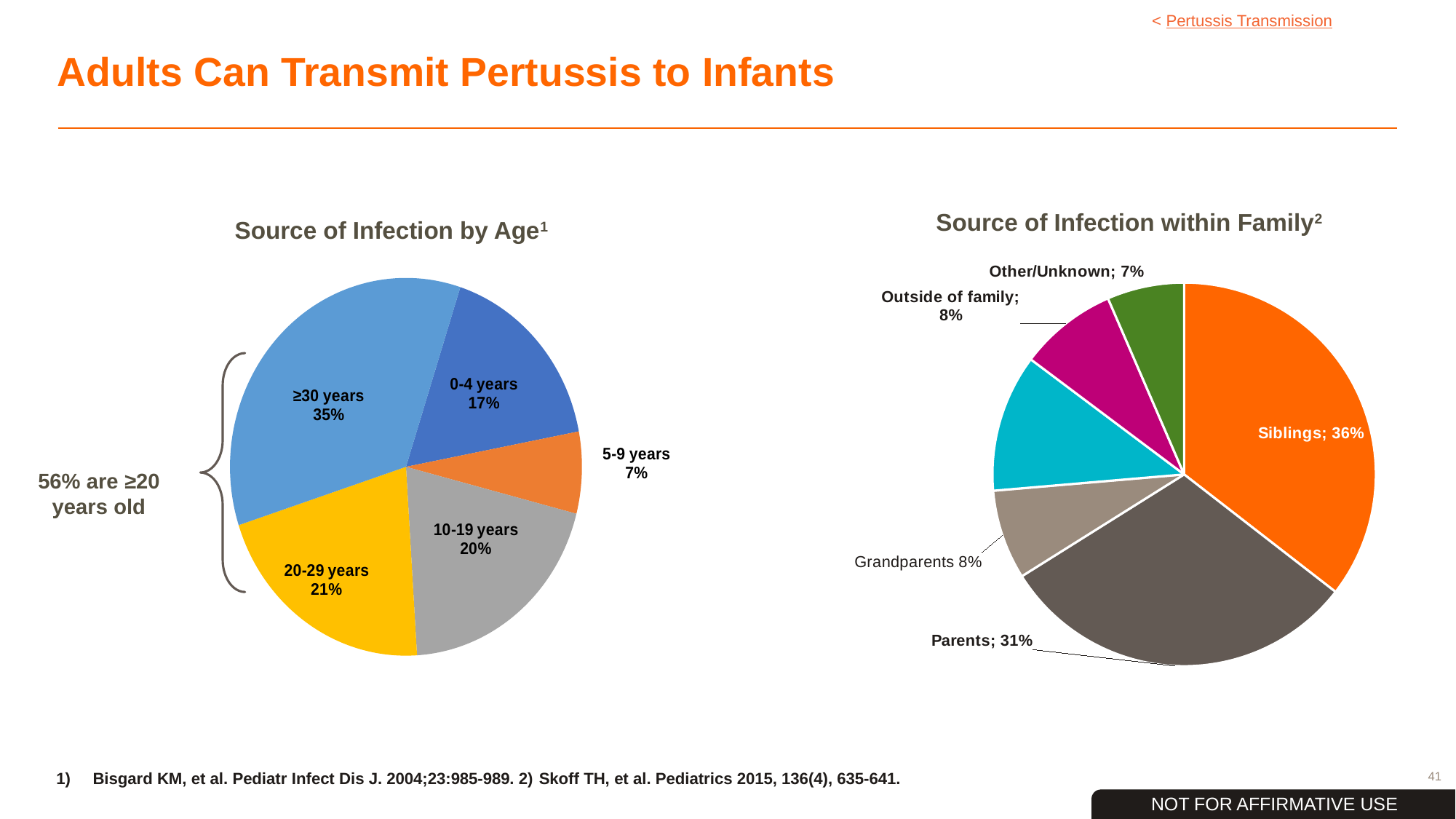
In the 'Source of Infection within Family' chart, what is the difference between the Siblings share and the Parents share? 5% How many age categories are shown in the 'Source of Infection by Age' chart? 5 In the 'Source of Infection within Family' chart, what percentage is attributed to Siblings? 36% In the 'Source of Infection by Age' chart, which age group has the smallest share? 5-9 years What type of chart is 'Source of Infection by Age'? Pie chart In the 'Source of Infection within Family' chart, what percentage is attributed to Parents? 31% In the 'Source of Infection within Family' chart, which is larger: Grandparents or Other/Unknown? Grandparents In the 'Source of Infection by Age' chart, what percentage is shown for 10-19 years? 20% In the 'Source of Infection by Age' chart, what share is attributed to the ≥30 years group? 35% According to the annotation next to the 'Source of Infection by Age' chart, what percentage of sources are ≥20 years old? 56% In the 'Source of Infection by Age' chart, what is the difference between the 20-29 years share and the 0-4 years share? 4% In the 'Source of Infection by Age' chart, which age group has the largest share? ≥30 years